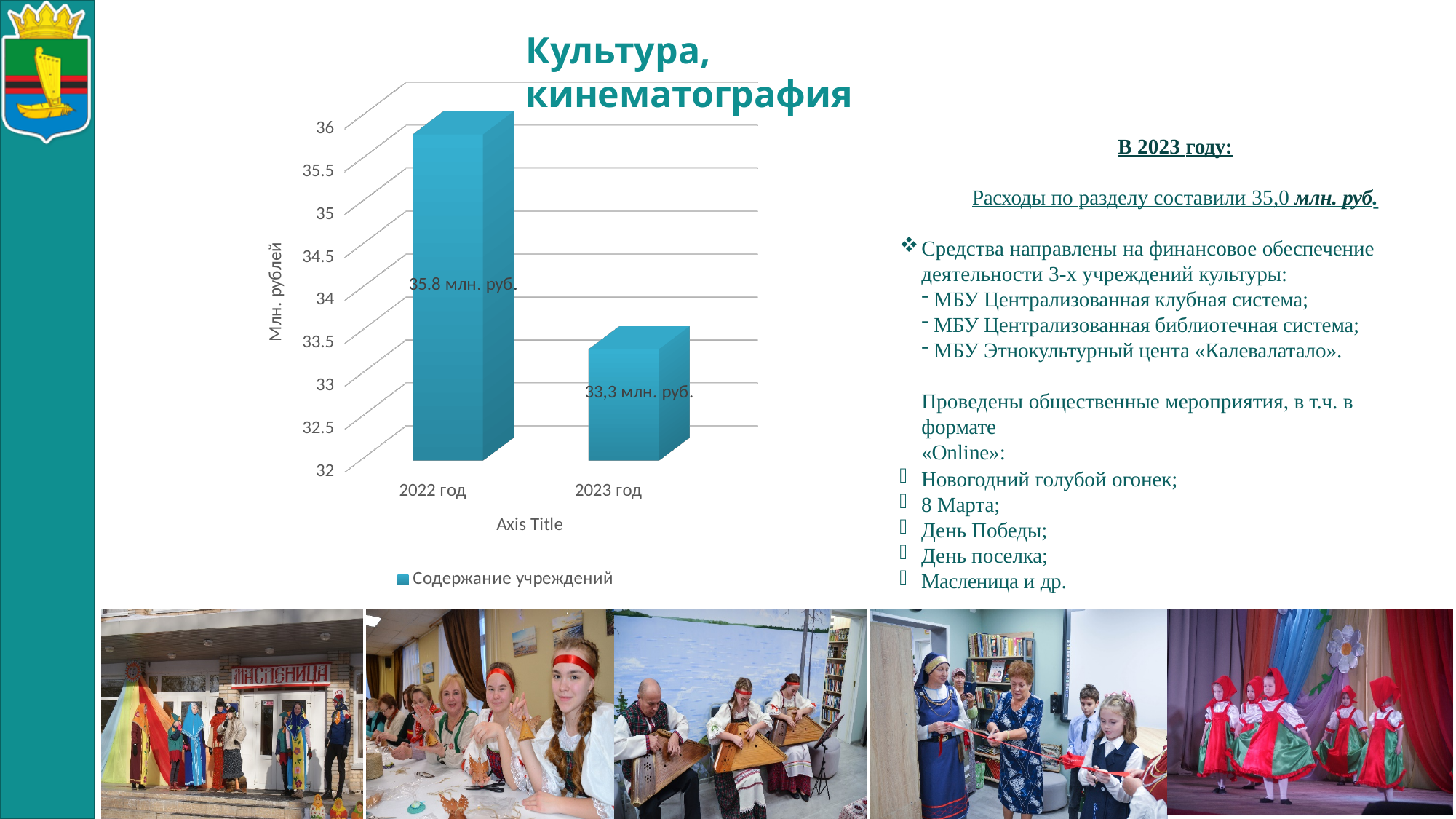
What is the name of the series in the legend? Содержание учреждений How many categories are shown on the x axis? 2 What is the value shown for 2022 год? 35.8 млн. руб. Is the value for 2023 год greater or less than 34? less Is the value for 2023 год larger or smaller than the value for 2022 год? smaller By how much does the value for 2022 год exceed the value for 2023 год? 2.5 млн. руб. How many series does the legend list? 1 What is the value shown for 2023 год? 33,3 млн. руб. Which year has the lower value? 2023 год Is the value for 2022 год greater or less than 35? greater Which year has the higher value? 2022 год What kind of chart is shown on the slide? bar chart